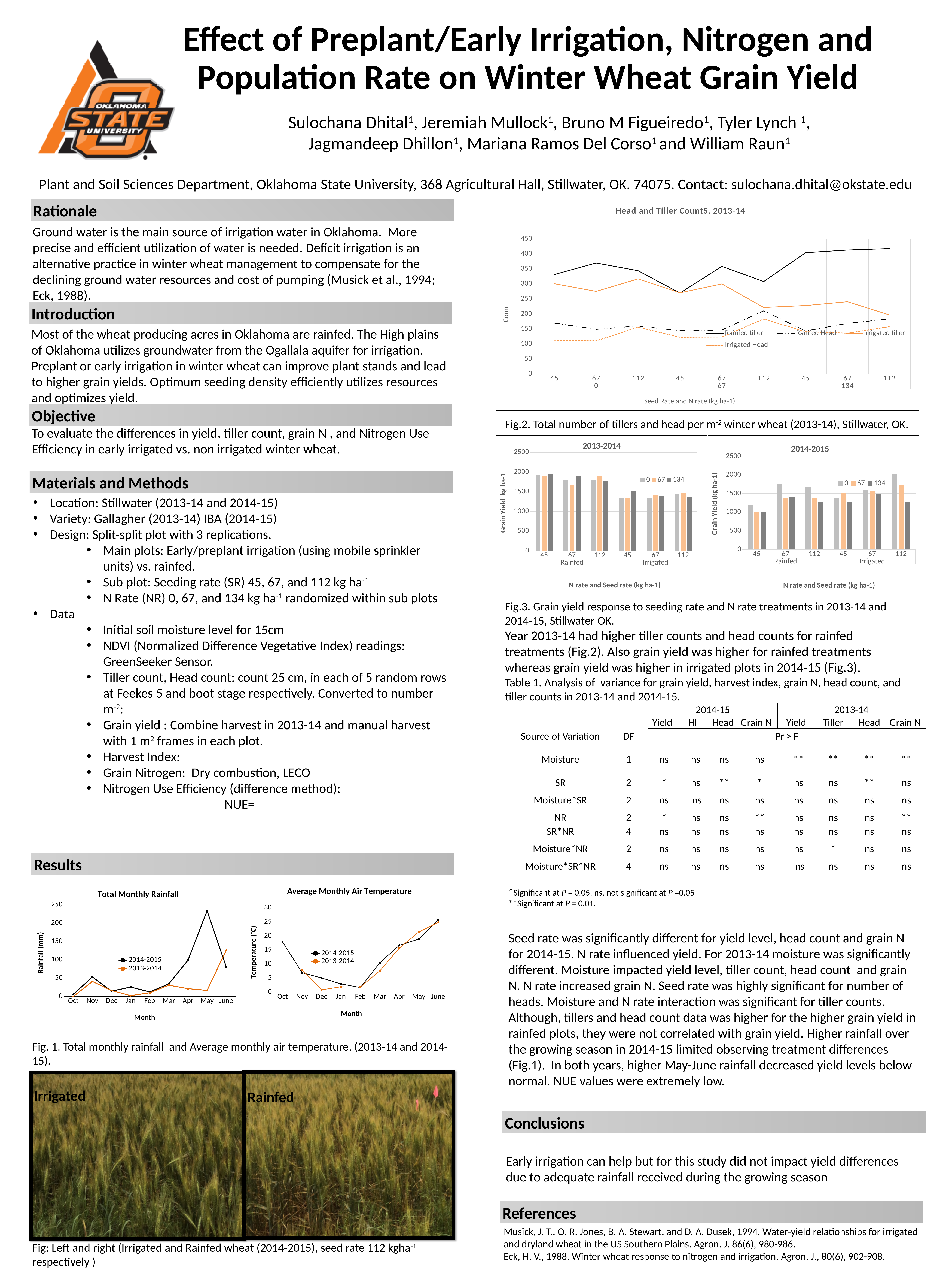
What kind of chart is the 'Head and Tiller CountS, 2013-14' chart? line chart In the '2014-2015' grain yield chart, is the value for the Rainfed 67 seed rate at N rate 0 greater or less than 1500? greater How many months are shown on the x axis of the 'Total Monthly Rainfall' chart? 9 In the 'Total Monthly Rainfall' chart, which month has the highest rainfall for the 2014-2015 series? May How many series does the legend of the '2013-2014' grain yield chart list? 3 What kind of chart is the '2014-2015' grain yield chart? bar chart How many series does the legend of the 'Head and Tiller CountS, 2013-14' chart list? 4 In the 'Average Monthly Air Temperature' chart, do the 2014-2015 values rise or fall from Feb to June? rise In the 'Head and Tiller CountS, 2013-14' chart, is the highest value of the Rainfed tiller series greater or less than 400? greater In the '2013-2014' grain yield chart, is the value for the Rainfed 45 seed rate at N rate 0 greater or less than 1500? greater In the 'Head and Tiller CountS, 2013-14' chart, which series reaches the highest value? Rainfed tiller